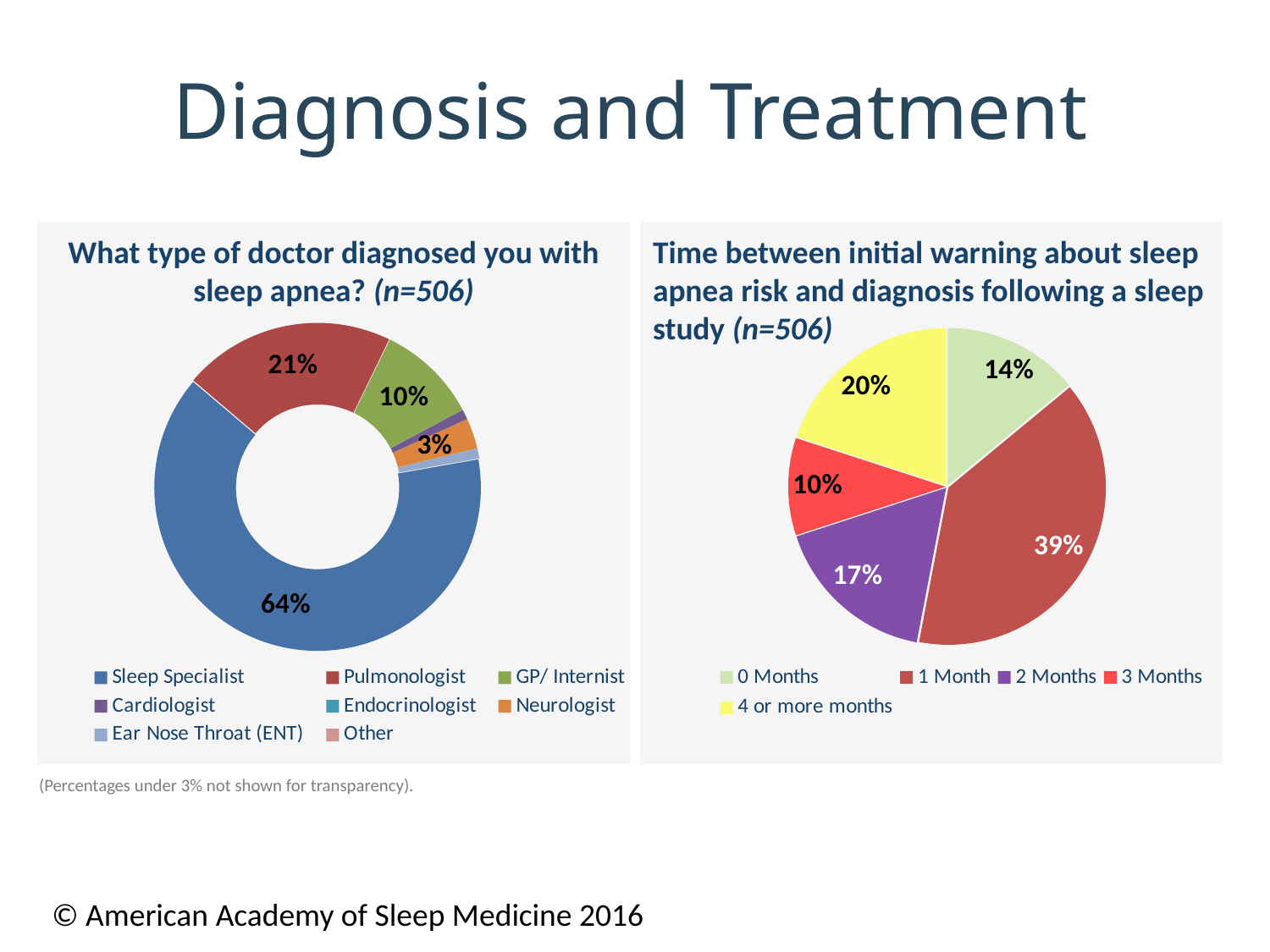
In the chart 'What type of doctor diagnosed you with sleep apnea?', what percentage were diagnosed by a GP/Internist? 10% How many categories does the chart 'Time between initial warning about sleep apnea risk and diagnosis following a sleep study' show? 5 What kind of chart is 'What type of doctor diagnosed you with sleep apnea?'? Doughnut chart How many entries does the legend of the chart 'What type of doctor diagnosed you with sleep apnea?' list? 8 In the chart 'What type of doctor diagnosed you with sleep apnea?', what percentage were diagnosed by a Pulmonologist? 21% In the chart 'What type of doctor diagnosed you with sleep apnea?', what percentage were diagnosed by a Sleep Specialist? 64% In the chart 'Time between initial warning about sleep apnea risk and diagnosis following a sleep study', which category has the smallest share? 3 Months In the chart 'What type of doctor diagnosed you with sleep apnea?', what is the difference between the Sleep Specialist and Pulmonologist shares? 43% In the chart 'What type of doctor diagnosed you with sleep apnea?', which type of doctor has the largest share? Sleep Specialist In the chart 'Time between initial warning about sleep apnea risk and diagnosis following a sleep study', which is larger: 0 Months or 2 Months? 2 Months In the chart 'Time between initial warning about sleep apnea risk and diagnosis following a sleep study', what percentage is 1 Month? 39% In the chart 'Time between initial warning about sleep apnea risk and diagnosis following a sleep study', what percentage is 4 or more months? 20%